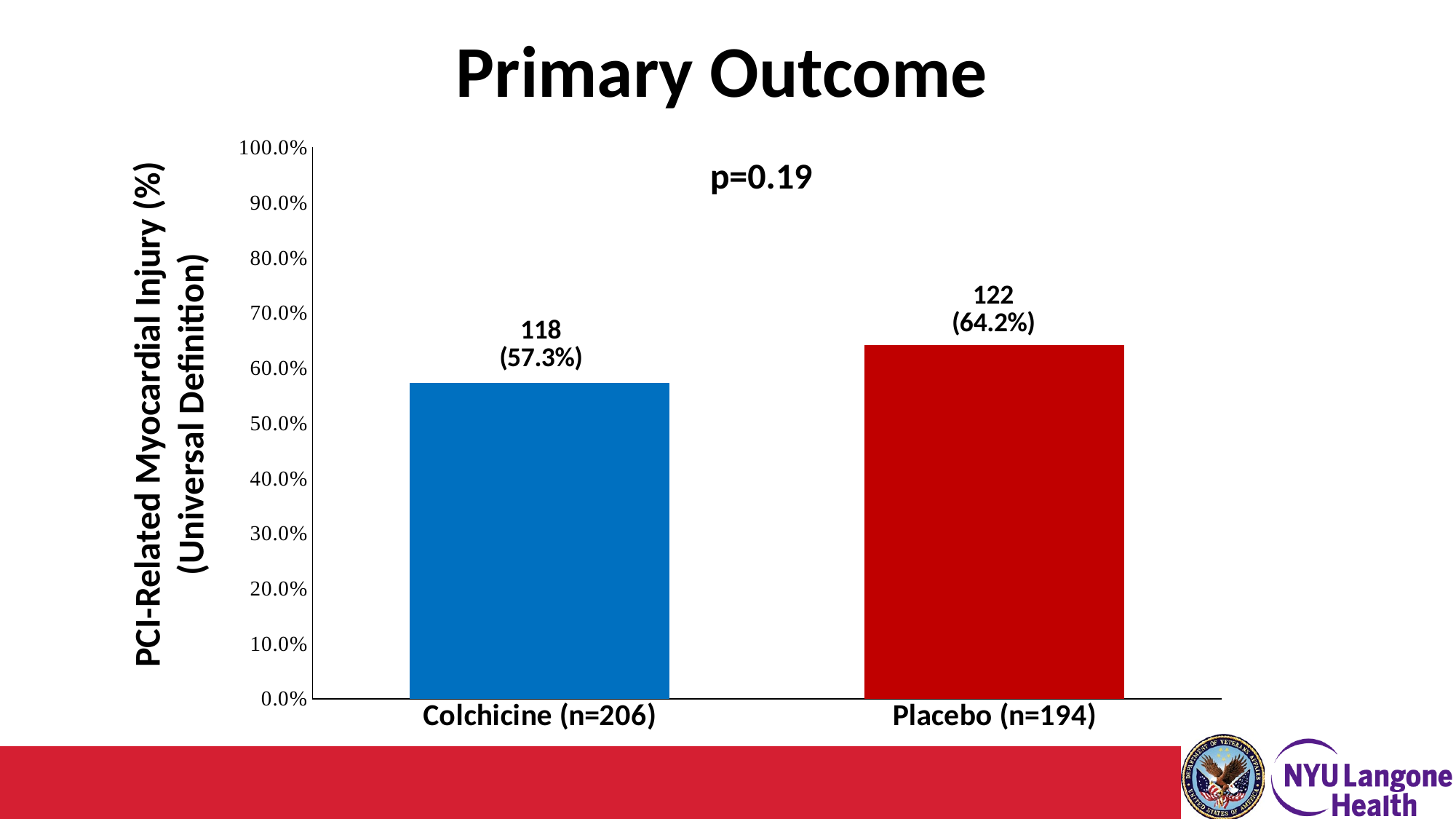
Which group has the lower rate of PCI-related myocardial injury? Colchicine (n=206) Which group has the higher rate of PCI-related myocardial injury? Placebo (n=194) What percentage of patients in the Placebo group had PCI-related myocardial injury? 64.2% What percentage of patients in the Colchicine group had PCI-related myocardial injury? 57.3% How many groups are shown on the chart? 2 Is the value for Colchicine greater or less than 60.0%? less How many patients in the Colchicine group had PCI-related myocardial injury? 118 Is the rate of PCI-related myocardial injury higher for Colchicine or Placebo? Placebo What p-value is shown on the chart? p=0.19 What is the difference in percentage points between the Placebo and Colchicine rates of PCI-related myocardial injury? 6.9 What type of chart is shown on the slide? Bar chart How many patients in the Placebo group had PCI-related myocardial injury? 122